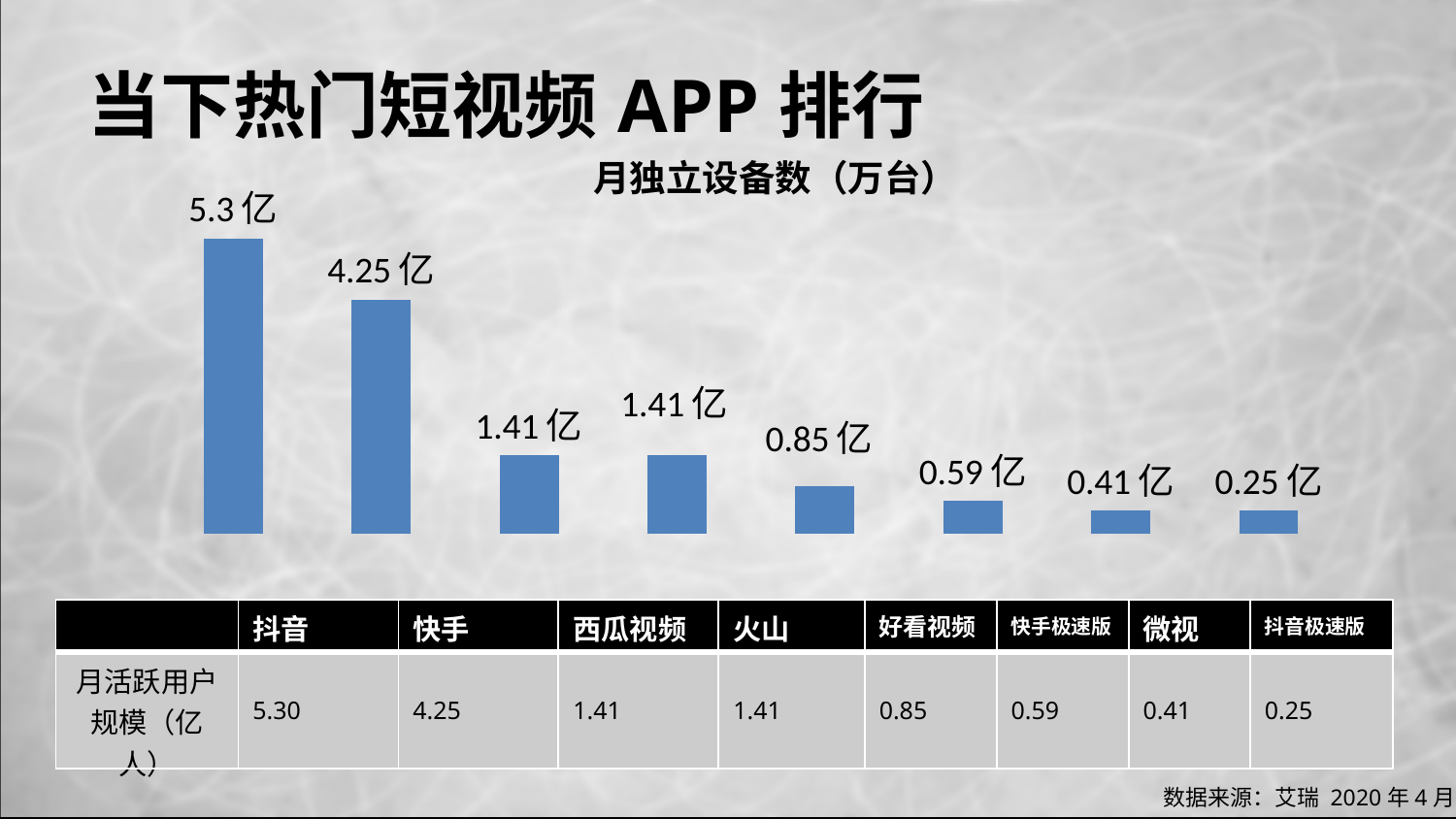
What is the value labelled on the bar for 抖音极速版? 0.25 亿 What is the value labelled on the bar for 好看视频? 0.85 亿 Which category has the highest bar in the chart? 抖音 Which is larger, the value for 快手极速版 or the value for 微视? 快手极速版 What is the title of the chart? 月独立设备数（万台） What type of chart is shown on the slide? bar chart How many bars are plotted in the chart? 8 What is the value labelled on the bar for 快手? 4.25 亿 What is the difference between the values for 抖音 and 快手? 1.05 亿 Which category has the lowest bar in the chart? 抖音极速版 What is the value labelled on the bar for 抖音? 5.3 亿 Do the bar values rise or fall from left to right across the chart? fall